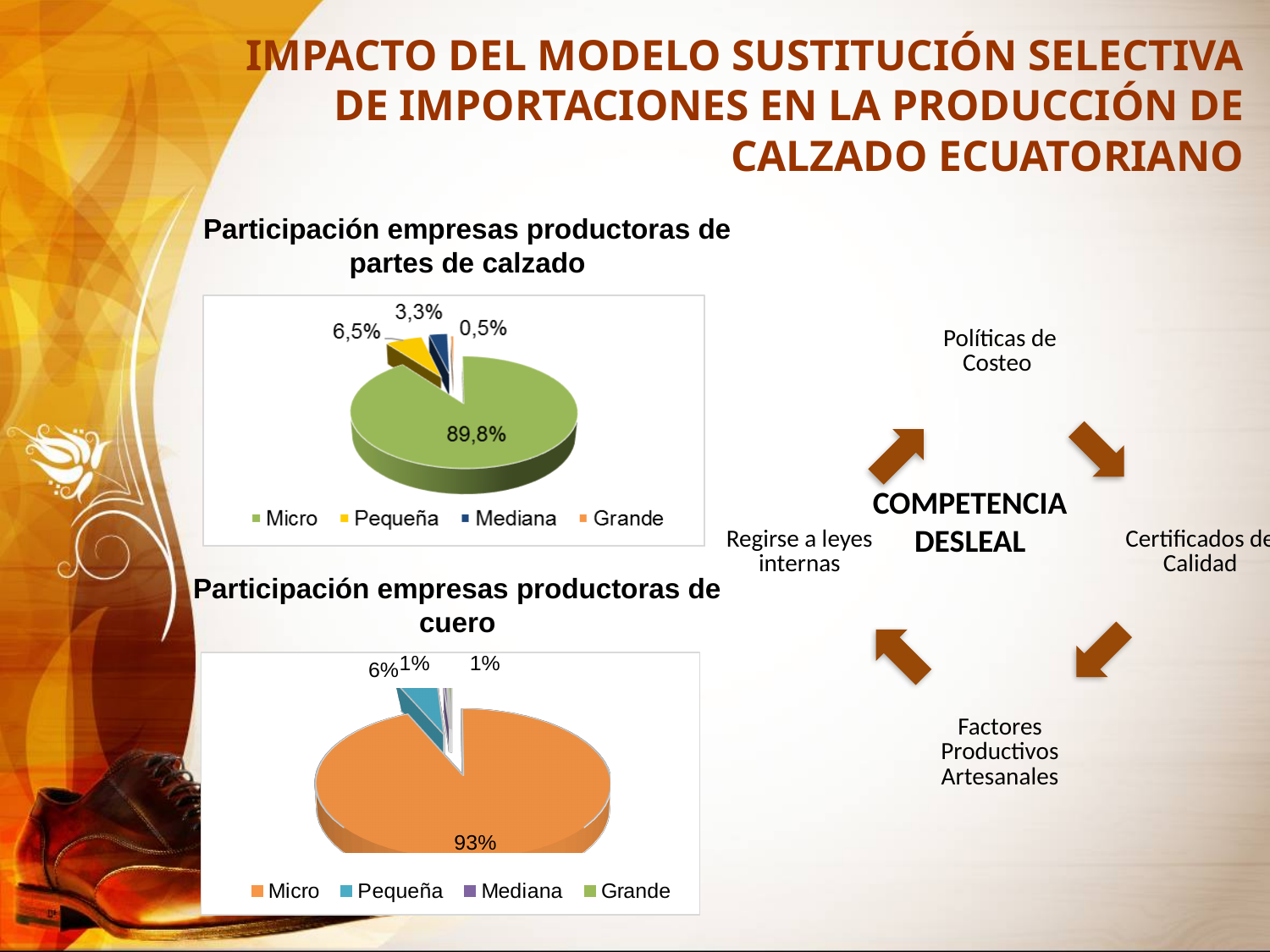
In the chart titled 'Participación empresas productoras de cuero', which category has the largest share? Micro In the chart titled 'Participación empresas productoras de cuero', what share do Pequeña companies have? 6% What type of chart is the one titled 'Participación empresas productoras de partes de calzado'? Pie chart In the chart titled 'Participación empresas productoras de cuero', what colour represents Micro? Orange In the chart titled 'Participación empresas productoras de partes de calzado', which category has the smallest share? Grande In the chart titled 'Participación empresas productoras de cuero', what share do Micro companies have? 93% In the chart titled 'Participación empresas productoras de partes de calzado', what share do Micro companies have? 89,8% In the chart titled 'Participación empresas productoras de partes de calzado', what share do Pequeña companies have? 6,5% In the chart titled 'Participación empresas productoras de cuero', how many categories does the legend list? 4 In the chart titled 'Participación empresas productoras de partes de calzado', what share do Mediana companies have? 3,3% In the chart titled 'Participación empresas productoras de partes de calzado', which category has the largest share? Micro In the chart titled 'Participación empresas productoras de partes de calzado', what is the difference between the Pequeña and Mediana shares? 3,2%